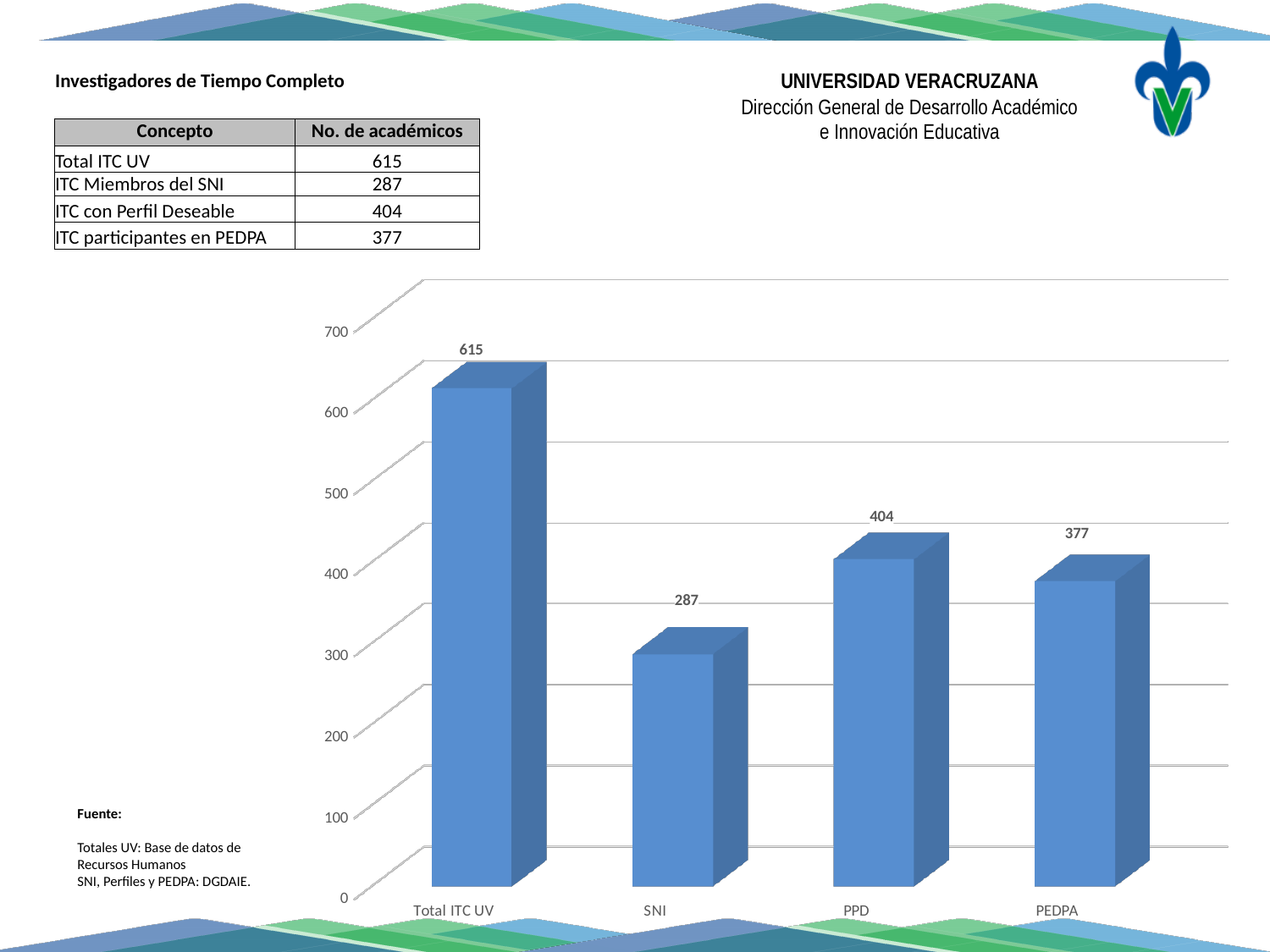
Is the value for SNI greater or less than 300? less Which category has the highest value? Total ITC UV What is the value for SNI? 287 What is the value for PPD? 404 What is the difference between the values for Total ITC UV and SNI? 328 What is the difference between the values for PPD and PEDPA? 27 What is the value for Total ITC UV? 615 How many categories are shown on the x axis? 4 Which category has the lowest value? SNI Which is larger, the value for PPD or the value for PEDPA? PPD What is the value for PEDPA? 377 What kind of chart is shown on the slide? bar chart